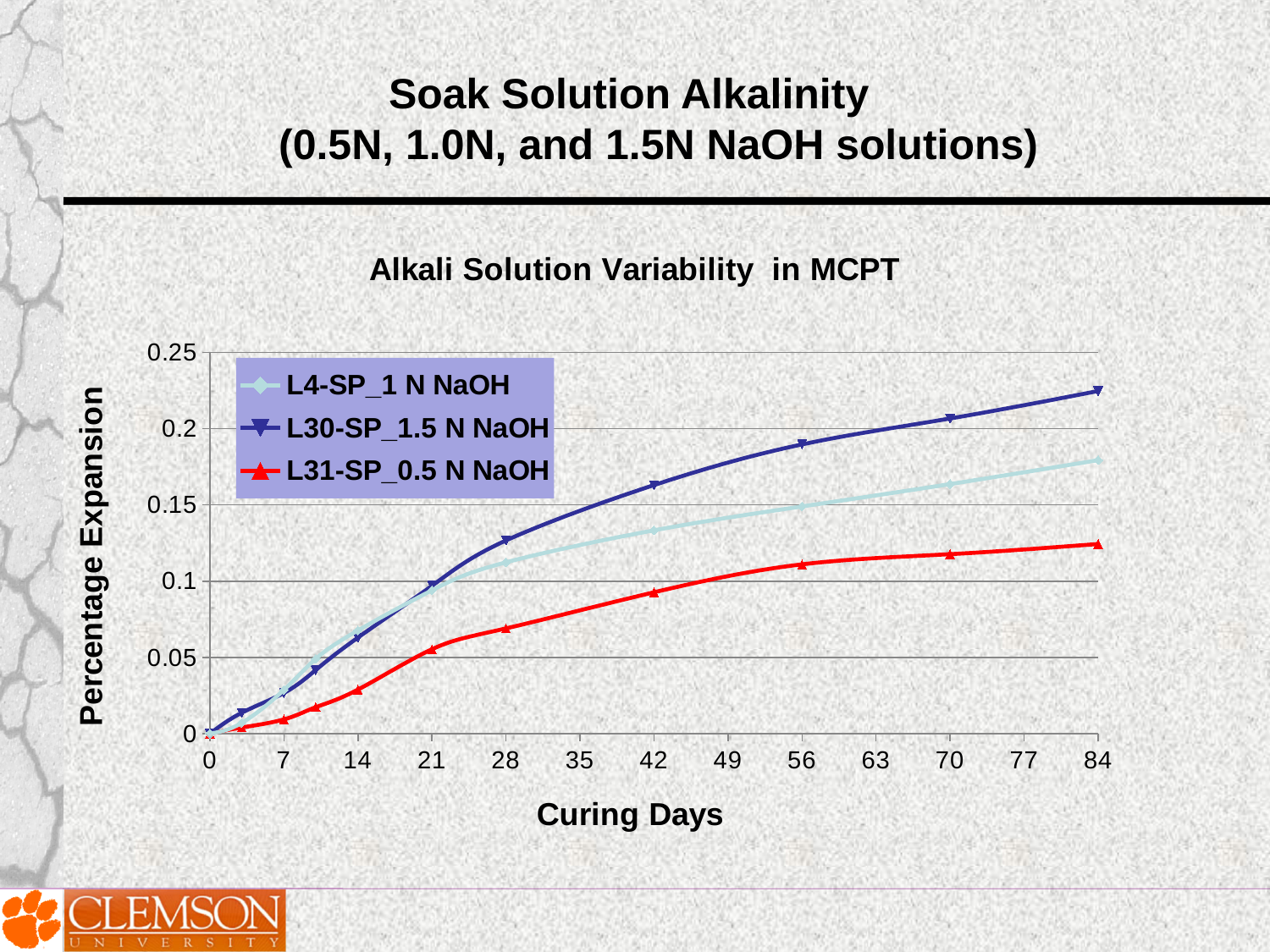
Which series has the lowest value at 84 curing days? L31-SP_0.5 N NaOH Is the value for L30-SP_1.5 N NaOH at 56 curing days greater or less than 0.15? greater What is the label of the y axis? Percentage Expansion What kind of chart is shown on the slide? line chart How many series does the legend list? 3 What is the title of the chart? Alkali Solution Variability in MCPT Do the values for L31-SP_0.5 N NaOH rise or fall as curing days increase? rise Which series has the highest value at 84 curing days? L30-SP_1.5 N NaOH Is the value for L30-SP_1.5 N NaOH at 84 curing days greater or less than 0.2? greater Is the value for L4-SP_1 N NaOH at 84 curing days greater or less than 0.2? less At 84 curing days, which is larger: L4-SP_1 N NaOH or L31-SP_0.5 N NaOH? L4-SP_1 N NaOH